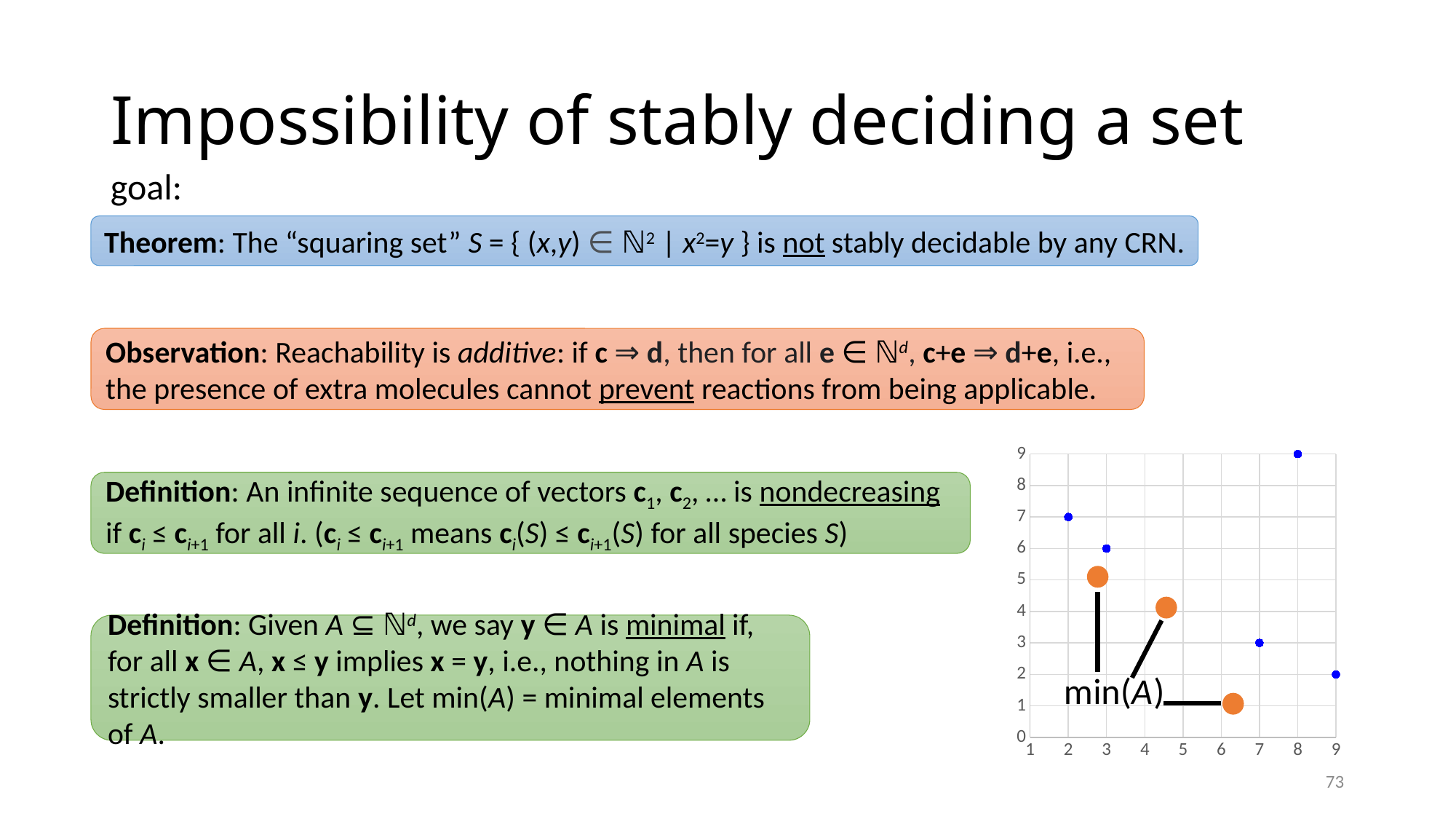
What kind of chart is shown on the right of the slide? scatter chart At which x value is the blue point with the lowest y value? 9 What is the y value of the blue point at x = 2? 7 Is the y value of the rightmost orange point greater or less than 2? less How many large orange points are plotted on the chart? 3 What is the y value of the blue point at x = 7? 3 Which blue point has a larger y value, the one at x = 2 or the one at x = 7? x = 2 At which x value is the blue point with the highest y value? 8 What is the y value of the blue point at x = 9? 2 How many small blue points are plotted on the chart? 5 What label is written next to the orange points on the chart? min(A) What is the y value of the blue point at x = 3? 6